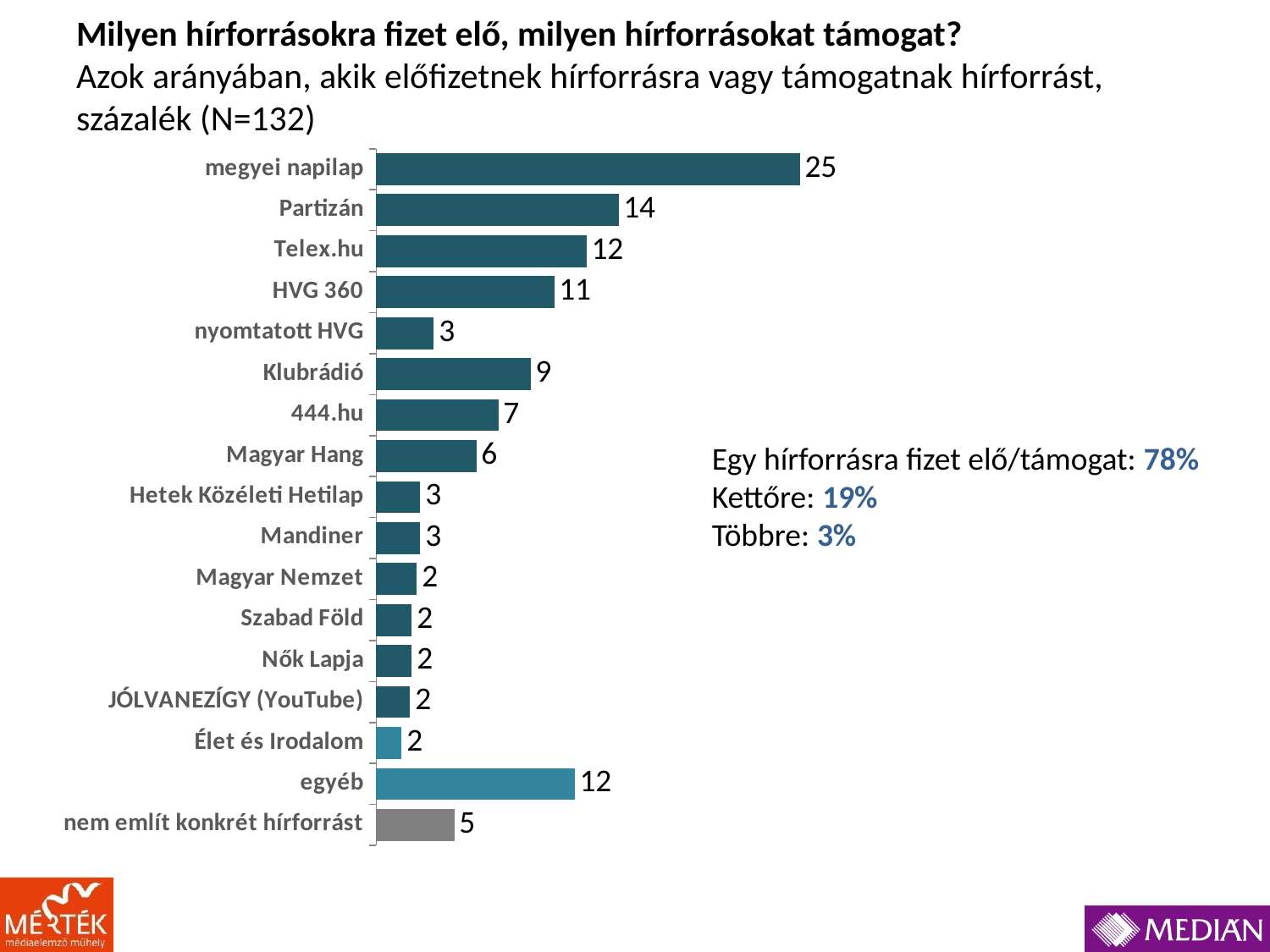
According to the text next to the chart, what share of respondents subscribe to or support only one news source (Egy hírforrásra fizet elő/támogat)? 78% What value is shown for megyei napilap? 25 What value is shown for Klubrádió? 9 What is the difference between the values for megyei napilap and Partizán? 11 What value is shown for nem említ konkrét hírforrást? 5 Which is larger, the value for 444.hu or the value for nyomtatott HVG? 444.hu How many categories are shown on the chart? 17 What kind of chart is shown on the slide? bar chart What is the difference between the values for Telex.hu and HVG 360? 1 What is the lowest value shown on the chart? 2 Which category has the highest value? megyei napilap What value is shown for Magyar Hang? 6